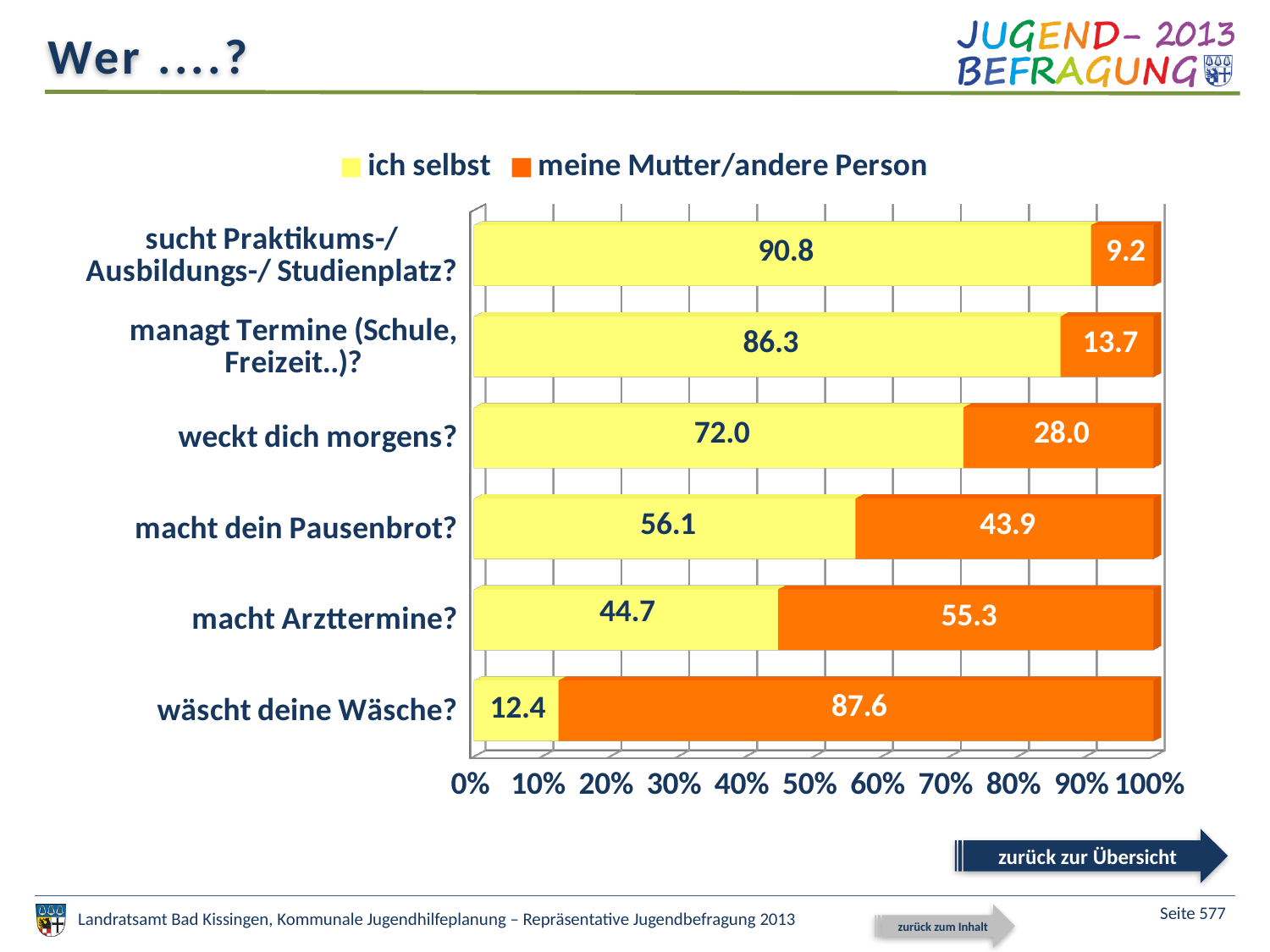
What is the value for "meine Mutter/andere Person" for "macht Arzttermine?"? 55.3 What is the value for "ich selbst" for "weckt dich morgens?"? 72.0 How many categories are shown on the chart? 6 Which category has the highest value for "ich selbst"? sucht Praktikums-/ Ausbildungs-/ Studienplatz? What is the total of the stacked bar for "weckt dich morgens?"? 100.0 For "macht dein Pausenbrot?", which is larger: "ich selbst" or "meine Mutter/andere Person"? ich selbst What is the difference between the "ich selbst" values for "managt Termine (Schule, Freizeit..)?" and "macht dein Pausenbrot?"? 30.2 What kind of chart is shown on the slide? stacked bar chart How many series does the legend list? 2 Which colour represents "meine Mutter/andere Person" in the legend? orange Which category has the lowest value for "meine Mutter/andere Person"? sucht Praktikums-/ Ausbildungs-/ Studienplatz? What is the value for "ich selbst" for "wäscht deine Wäsche?"? 12.4